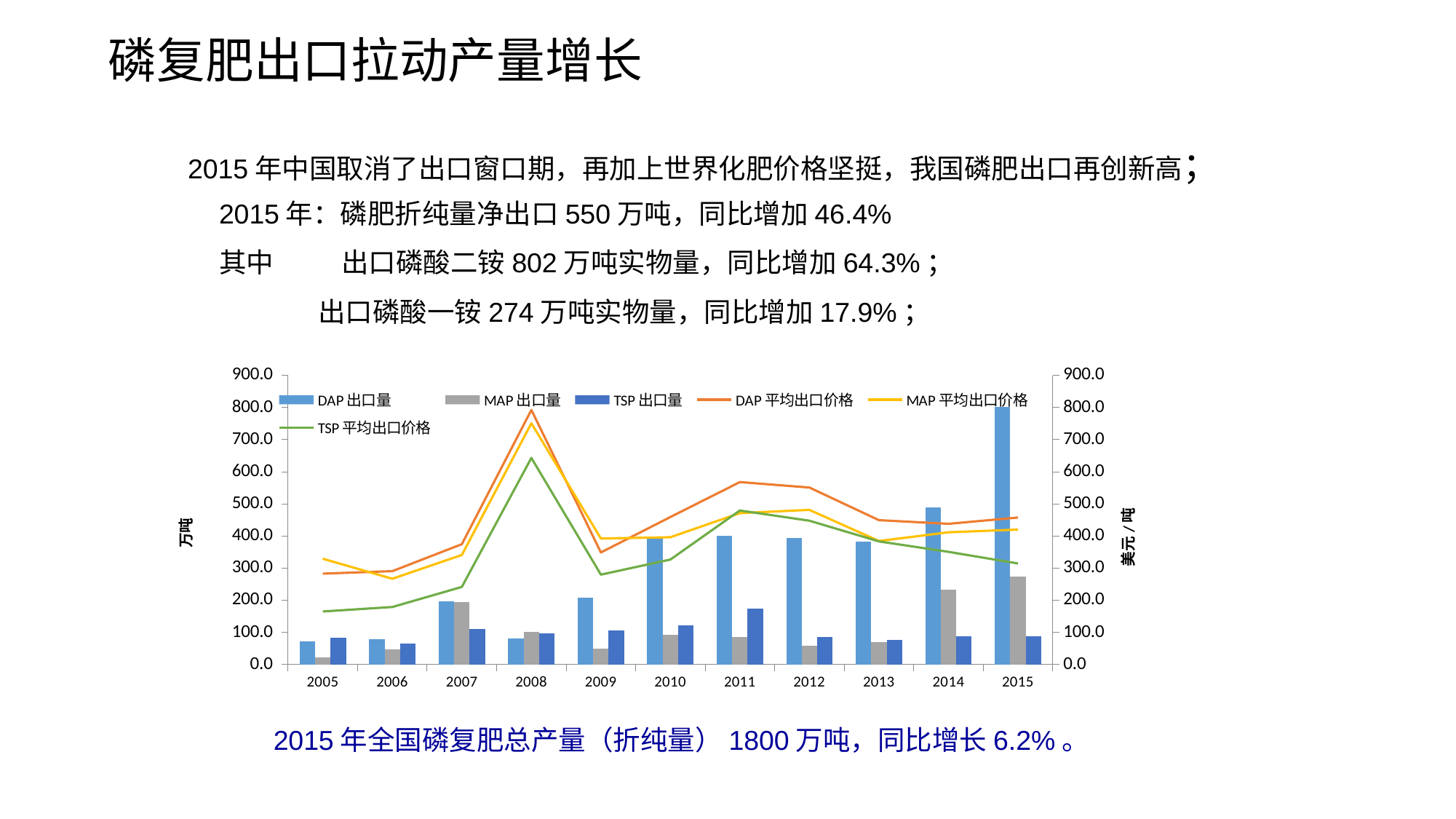
In which year is the DAP 出口量 bar the highest? 2015 How many years are shown on the x axis of the chart? 11 Is the MAP 出口量 value for 2005 greater or less than 100? less What kind of chart is shown on the slide? Combined bar and line chart Which year has the larger DAP 出口量 bar, 2009 or 2011? 2011 In which year is the TSP 出口量 bar the highest? 2011 Is the DAP 出口量 value for 2015 greater or less than 700? greater What is the label on the right-hand vertical axis of the chart? 美元/吨 How many series does the chart legend list? 6 In which year is the DAP 出口量 bar the lowest? 2005 Is the TSP 平均出口价格 value for 2008 greater or less than 600? greater In which year does the DAP 平均出口价格 line reach its peak? 2008